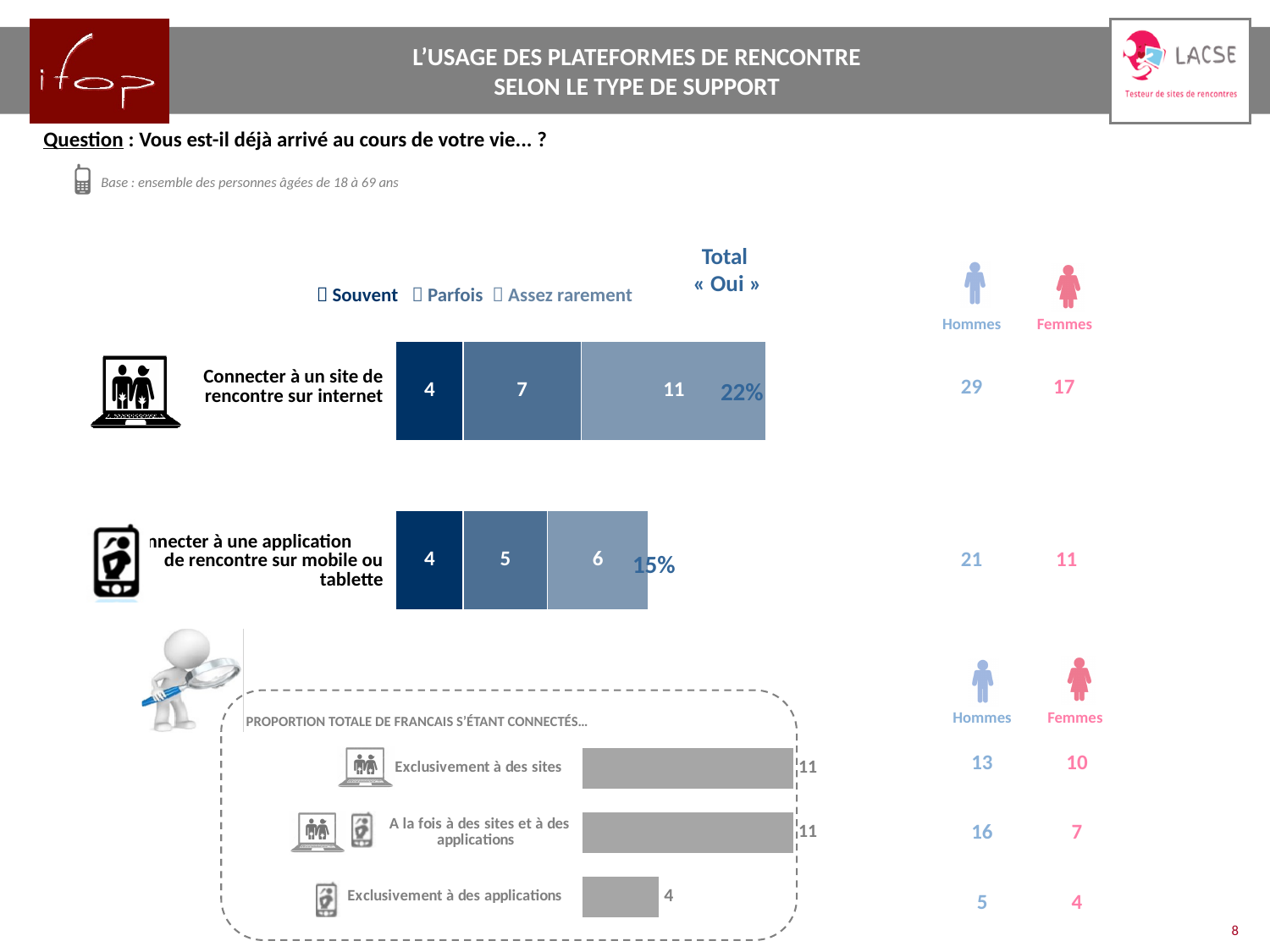
In the top stacked bar chart, how many series does the legend list? 3 In the lower bar chart 'Proportion totale de Français s'étant connectés…', which category has the lowest value? Exclusivement à des applications In the top stacked bar chart, what is the 'Souvent' value for 'Connecter à un site de rencontre sur internet'? 4 In the lower bar chart 'Proportion totale de Français s'étant connectés…', what is the value for 'A la fois à des sites et à des applications'? 11 In the top stacked bar chart, what is the 'Parfois' value for 'Connecter à un site de rencontre sur internet'? 7 In the top stacked bar chart, what is the 'Assez rarement' value for 'Connecter à une application de rencontre sur mobile ou tablette'? 6 In the top stacked bar chart, what is the 'Total « Oui »' shown for 'Connecter à une application de rencontre sur mobile ou tablette'? 15% In the lower bar chart 'Proportion totale de Français s'étant connectés…', what is the value for 'Exclusivement à des applications'? 4 In the top stacked bar chart, which category has the higher 'Assez rarement' value? Connecter à un site de rencontre sur internet In the top stacked bar chart, what is the 'Total « Oui »' shown for 'Connecter à un site de rencontre sur internet'? 22% In the top stacked bar chart, what is the difference between the 'Parfois' values for the site and the application categories? 2 What type of chart is used in the dashed box 'Proportion totale de Français s'étant connectés…'? Bar chart